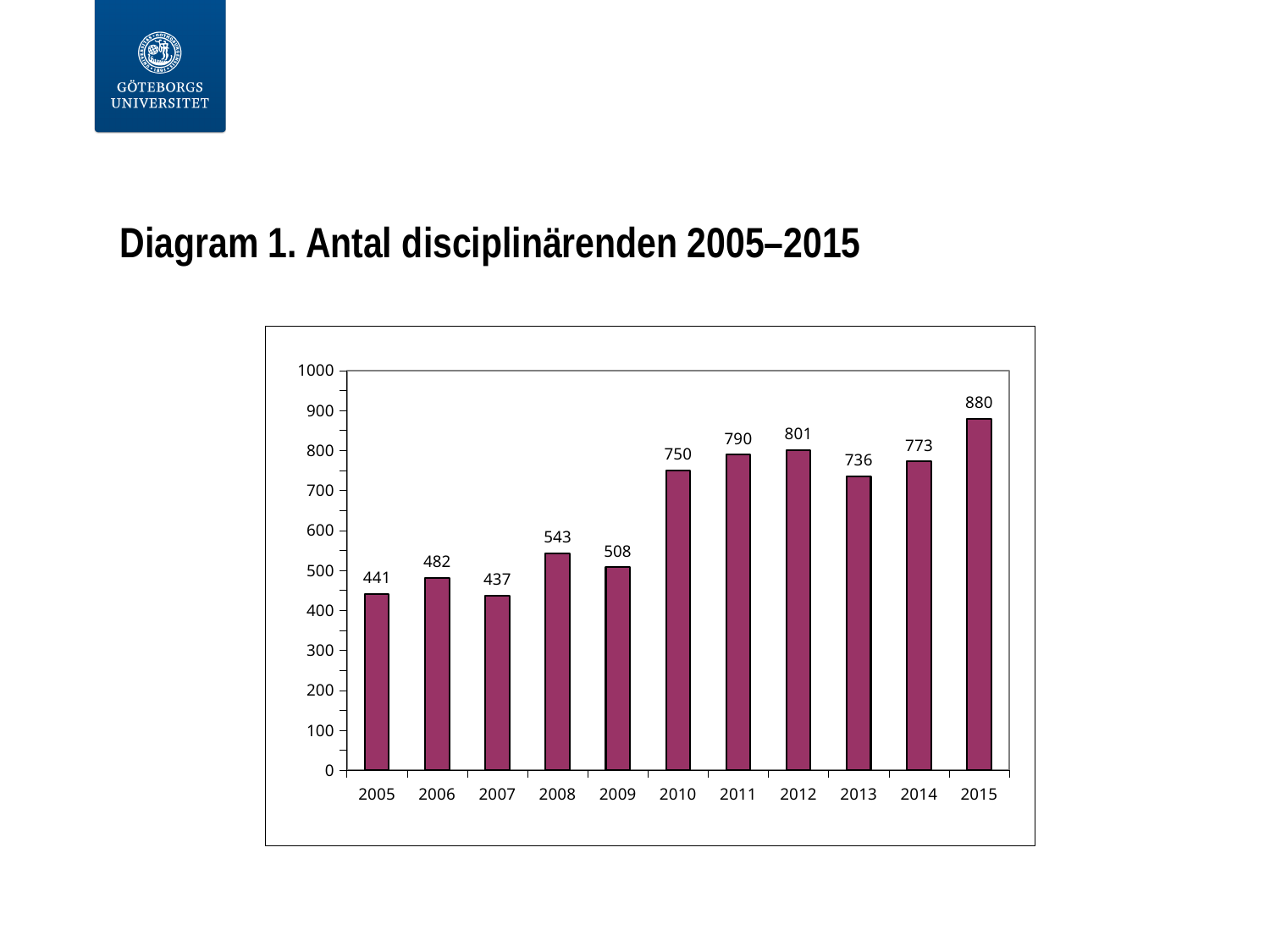
What is the title of the chart on the slide? Diagram 1. Antal disciplinärenden 2005–2015 Is the value for 2009 greater or less than 600? less What is the value for 2007? 437 Which is larger, the value for 2011 or the value for 2014? 2011 What is the difference between the values for 2012 and 2013? 65 What is the difference between the values for 2015 and 2005? 439 What kind of chart is shown on the slide? bar chart What is the value for 2010? 750 Which year has the highest value? 2015 How many years are shown on the x axis? 11 What is the value for 2013? 736 Which year has the lowest value? 2007